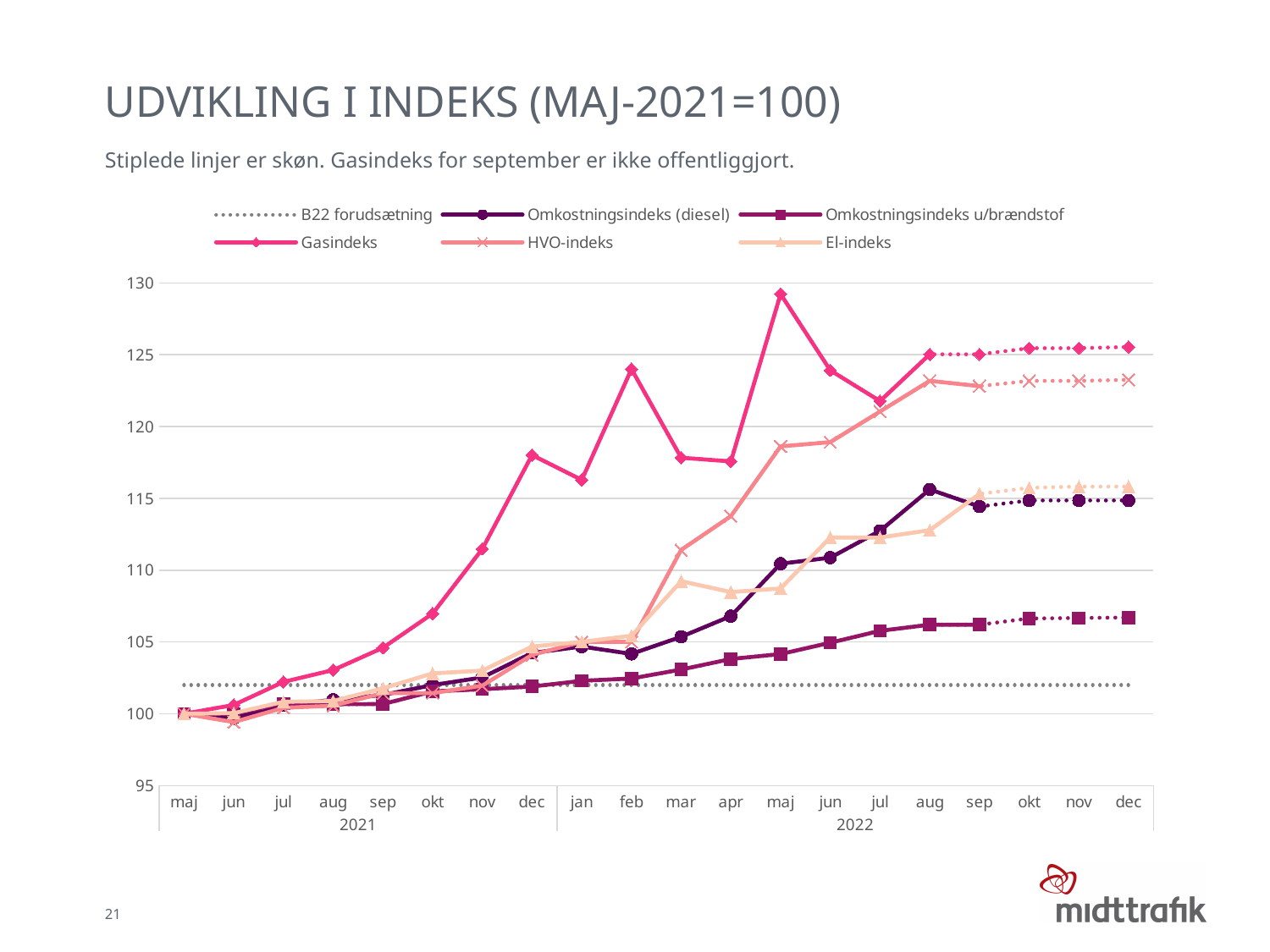
Does the Gasindeks series rise or fall from maj 2021 to maj 2022? rise Is the value for HVO-indeks in aug 2022 greater or less than 120? greater In jun 2022, is the value for HVO-indeks or Omkostningsindeks (diesel) larger? HVO-indeks Which series has the lowest value in dec 2022? B22 forudsætning How many series does the legend list? 6 What kind of chart is shown on the slide? line chart What is the title of the chart slide? UDVIKLING I INDEKS (MAJ-2021=100) Is the value for Gasindeks in maj 2022 greater or less than 125? greater How many months are plotted along the x axis? 20 Is the value for B22 forudsætning in jan 2022 greater or less than 105? less Which series has the highest value in maj 2022? Gasindeks